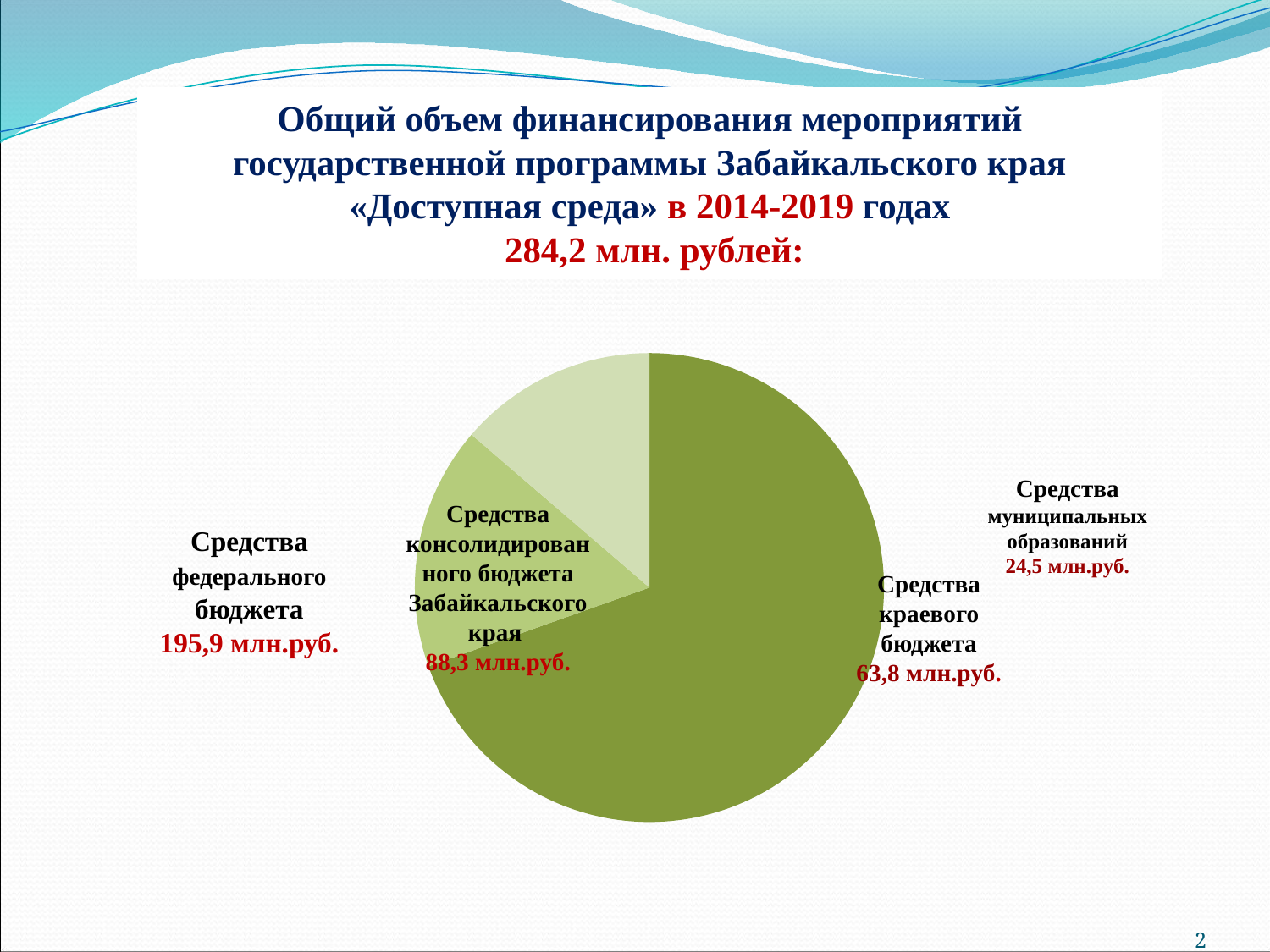
Which is larger: Средства краевого бюджета or Средства муниципальных образований? Средства краевого бюджета What is the value for Средства федерального бюджета in the pie chart? 195,9 млн.руб. Which funding source has the largest slice of the pie chart? Средства федерального бюджета What kind of chart is shown on the slide? Pie chart Which funding source has the smallest slice of the pie chart? Средства муниципальных образований What is the difference between Средства краевого бюджета and Средства муниципальных образований? 39,3 млн.руб. What is the difference between Средства федерального бюджета and Средства краевого бюджета? 132,1 млн.руб. What is the value for Средства муниципальных образований in the pie chart? 24,5 млн.руб. What is the total funding volume stated on the slide for 2014-2019? 284,2 млн. рублей How many slices does the pie chart have? 3 What is the value shown for Средства консолидированного бюджета Забайкальского края? 88,3 млн.руб. What is the value for Средства краевого бюджета in the pie chart? 63,8 млн.руб.